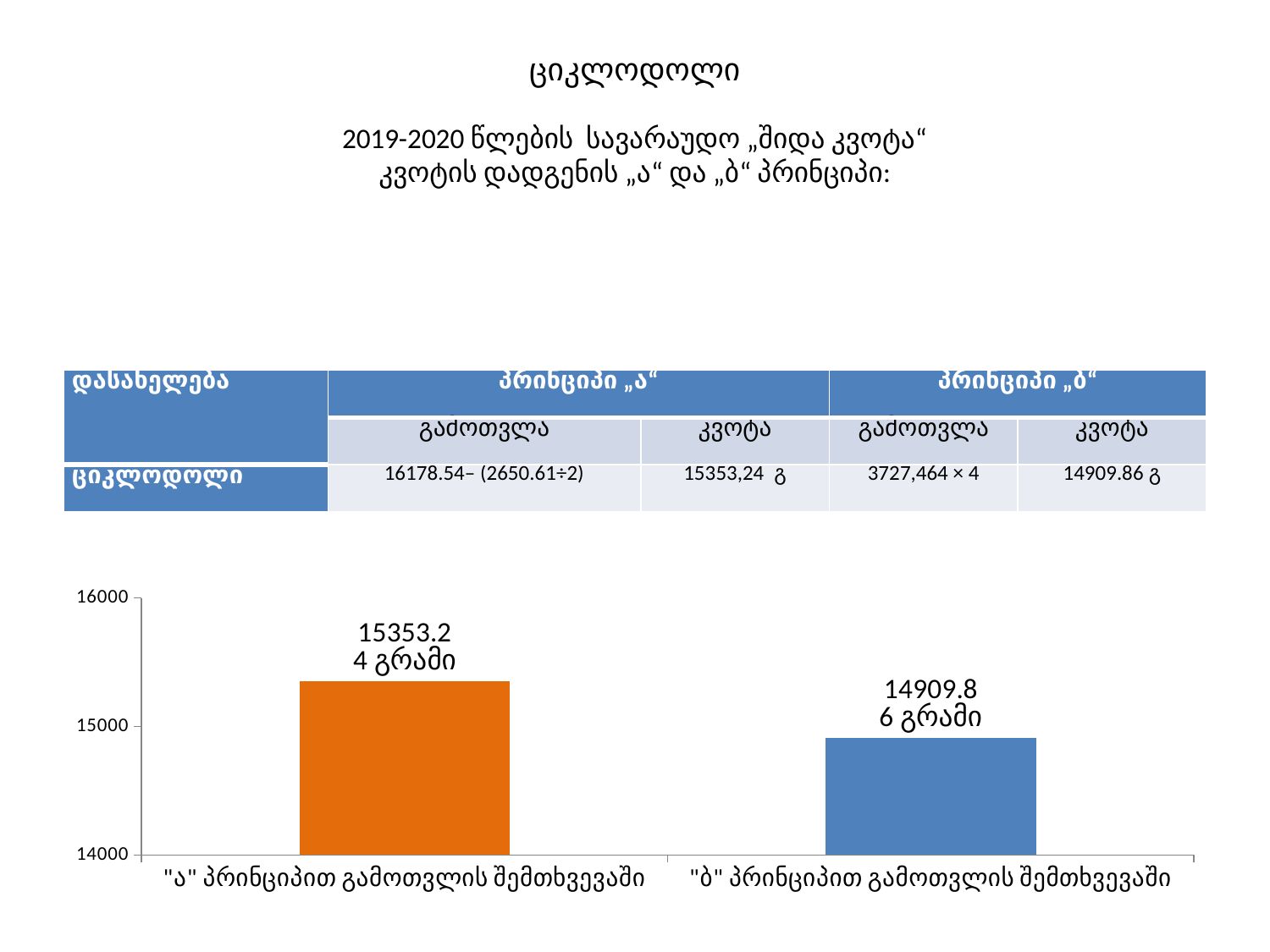
Is the value for "ბ" პრინციპით გამოთვლის შემთხვევაში greater or less than 15000? less How many bars does the chart have? 2 Is the value for "ა" პრინციპით გამოთვლის შემთხვევაში greater or less than 15000? greater Is the value for principle "ა" larger or smaller than the value for principle "ბ"? larger What is the lowest value shown on the vertical axis? 14000 Which category has the higher value? "ა" პრინციპით გამოთვლის შემთხვევაში What colour is the bar for "ა" პრინციპით გამოთვლის შემთხვევაში? orange What is the value shown for "ბ" პრინციპით გამოთვლის შემთხვევაში? 14909.86 გრამი What is the value shown for "ა" პრინციპით გამოთვლის შემთხვევაში? 15353.24 გრამი What type of chart is shown on the slide? bar chart What is the difference between the values for principle "ა" and principle "ბ"? 443.38 Which category has the lower value? "ბ" პრინციპით გამოთვლის შემთხვევაში